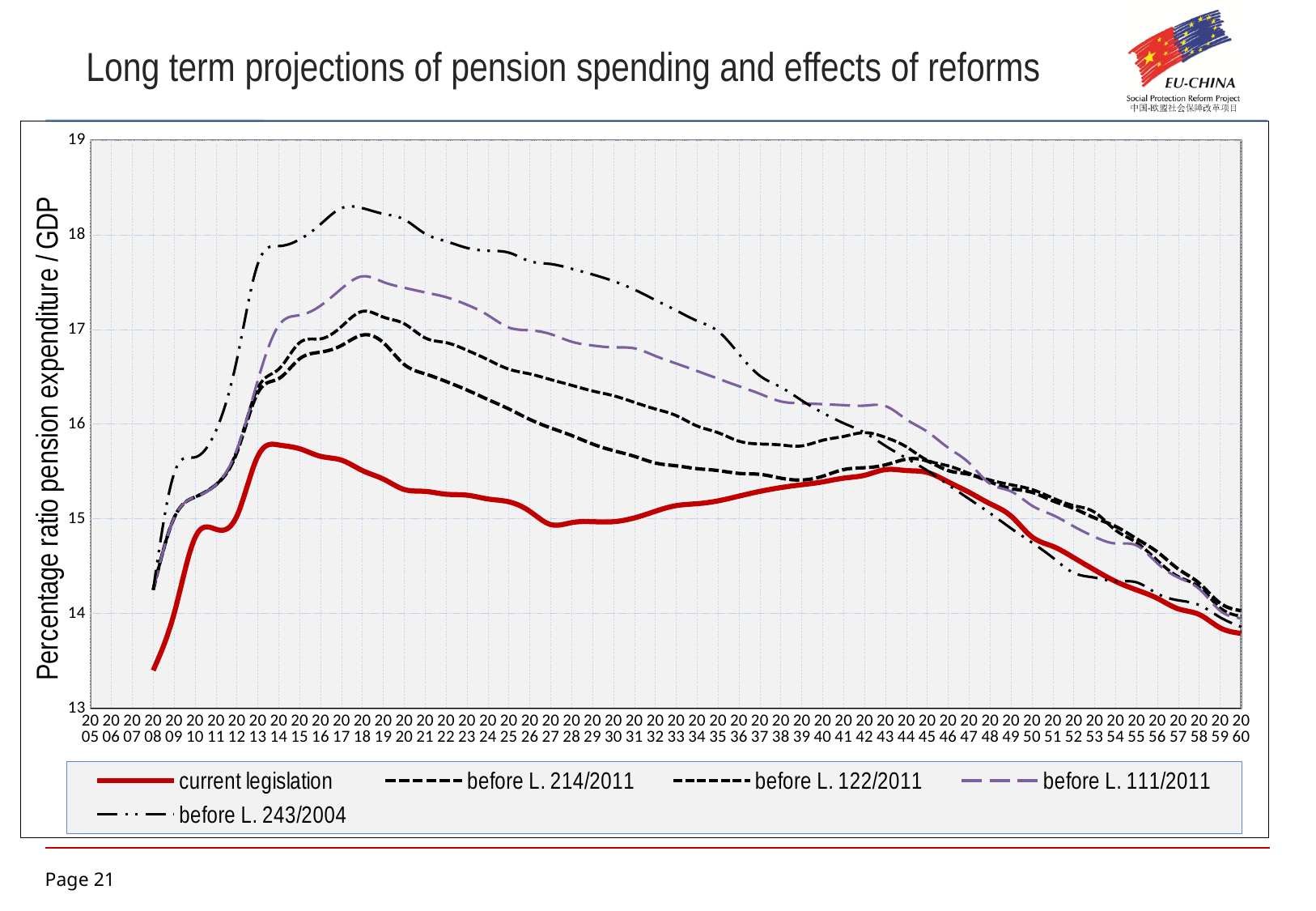
Is the value for before L. 111/2011 in 2018 greater or less than 17? greater Is the value for current legislation in 2008 greater or less than 14? less Which series has the highest value in 2018? before L. 243/2004 Is the value for current legislation in 2060 greater or less than 14? less Does the current legislation series rise or fall from 2045 to 2060? fall Which series has the lowest value in 2018? current legislation What kind of chart is shown on the slide? line chart What is the title of the slide's chart? Long term projections of pension spending and effects of reforms How many series does the legend list? 5 What is the label of the vertical axis? Percentage ratio pension expenditure / GDP In 2020, which is larger: the value for before L. 243/2004 or the value for current legislation? before L. 243/2004